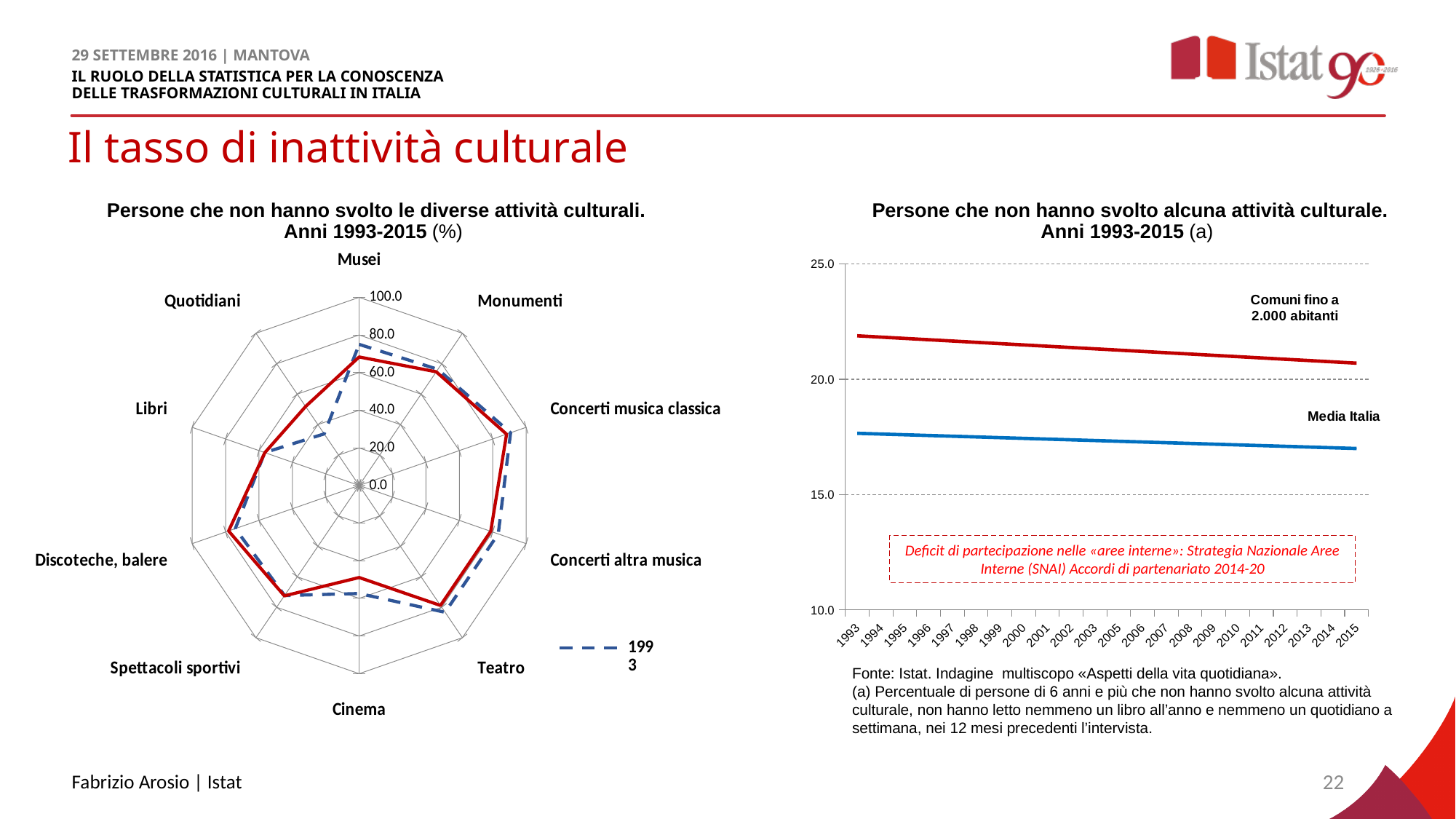
In the right line chart, is the value for 'Media Italia' in 1993 greater or less than 15.0? greater In the right line chart, which series has the higher values across all years, 'Comuni fino a 2.000 abitanti' or 'Media Italia'? Comuni fino a 2.000 abitanti What kind of chart is the right chart titled 'Persone che non hanno svolto alcuna attività culturale'? line chart In the right line chart, how many series are plotted? 2 What kind of chart is the left chart titled 'Persone che non hanno svolto le diverse attività culturali'? radar chart In the right line chart, is the value for 'Media Italia' in 2015 greater or less than 20.0? less In the left radar chart, is the value for 'Concerti musica classica' on the solid red line greater or less than 80.0? greater In the right line chart, do the values for 'Comuni fino a 2.000 abitanti' rise or fall from 1993 to 2015? fall In the left radar chart, how many cultural activity categories are plotted around the axes? 10 In the left radar chart, which year does the dashed blue line in the legend represent? 1993